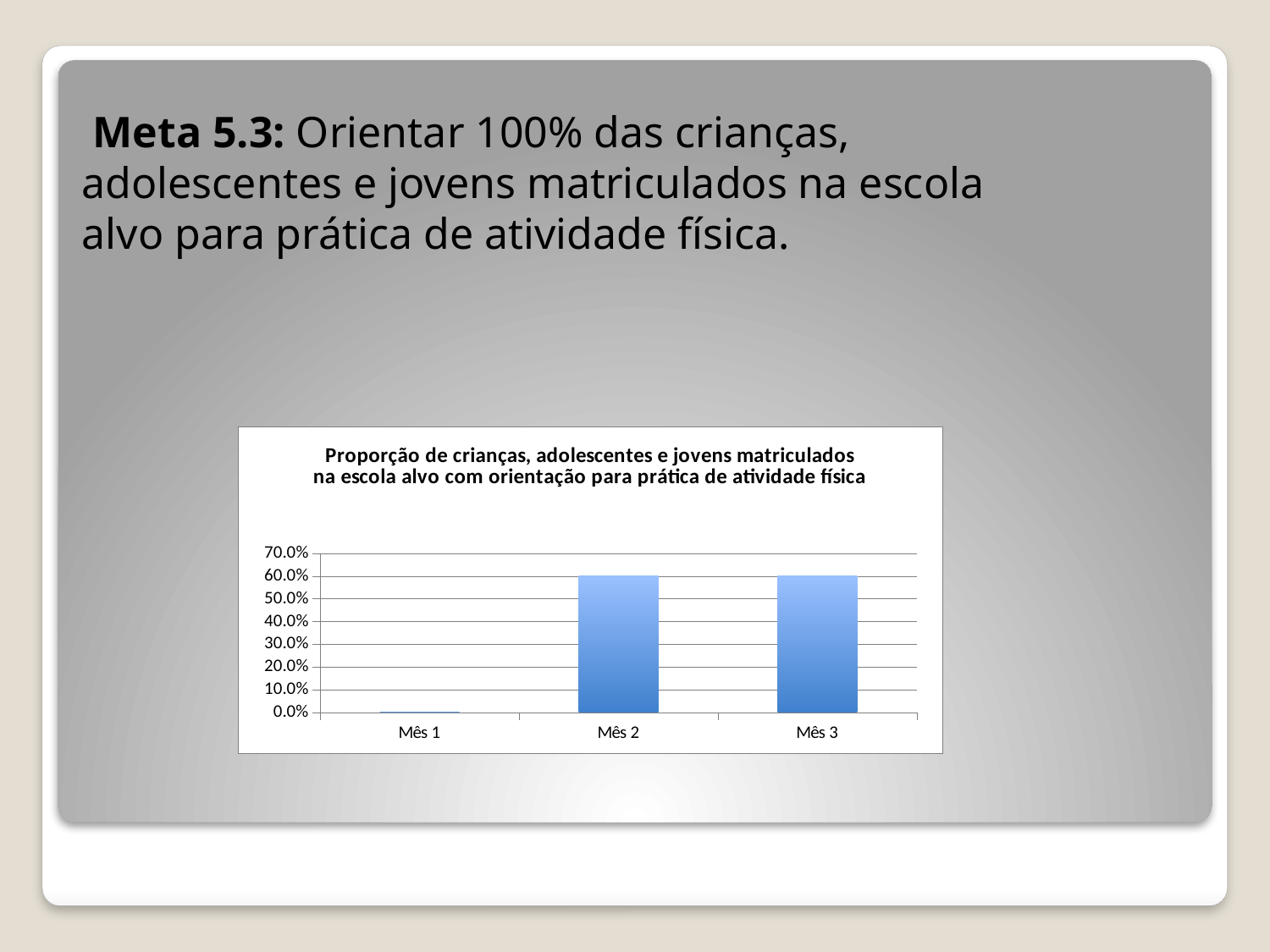
What is the value for Mês 2? 60.0% What is the value for Mês 1? 0.0% Which is larger, the value for Mês 1 or the value for Mês 2? Mês 2 Is the value for Mês 3 greater or less than 70.0%? less What is the difference between the values for Mês 2 and Mês 1? 60.0% Is the value for Mês 2 greater or less than 50.0%? greater What is the value for Mês 3? 60.0% How many categories are shown on the x axis of the chart? 3 What is the title of the chart? Proporção de crianças, adolescentes e jovens matriculados na escola alvo com orientação para prática de atividade física What kind of chart is shown on the slide? bar chart Do the values rise or fall from Mês 1 to Mês 3? rise Which month has the lowest value? Mês 1